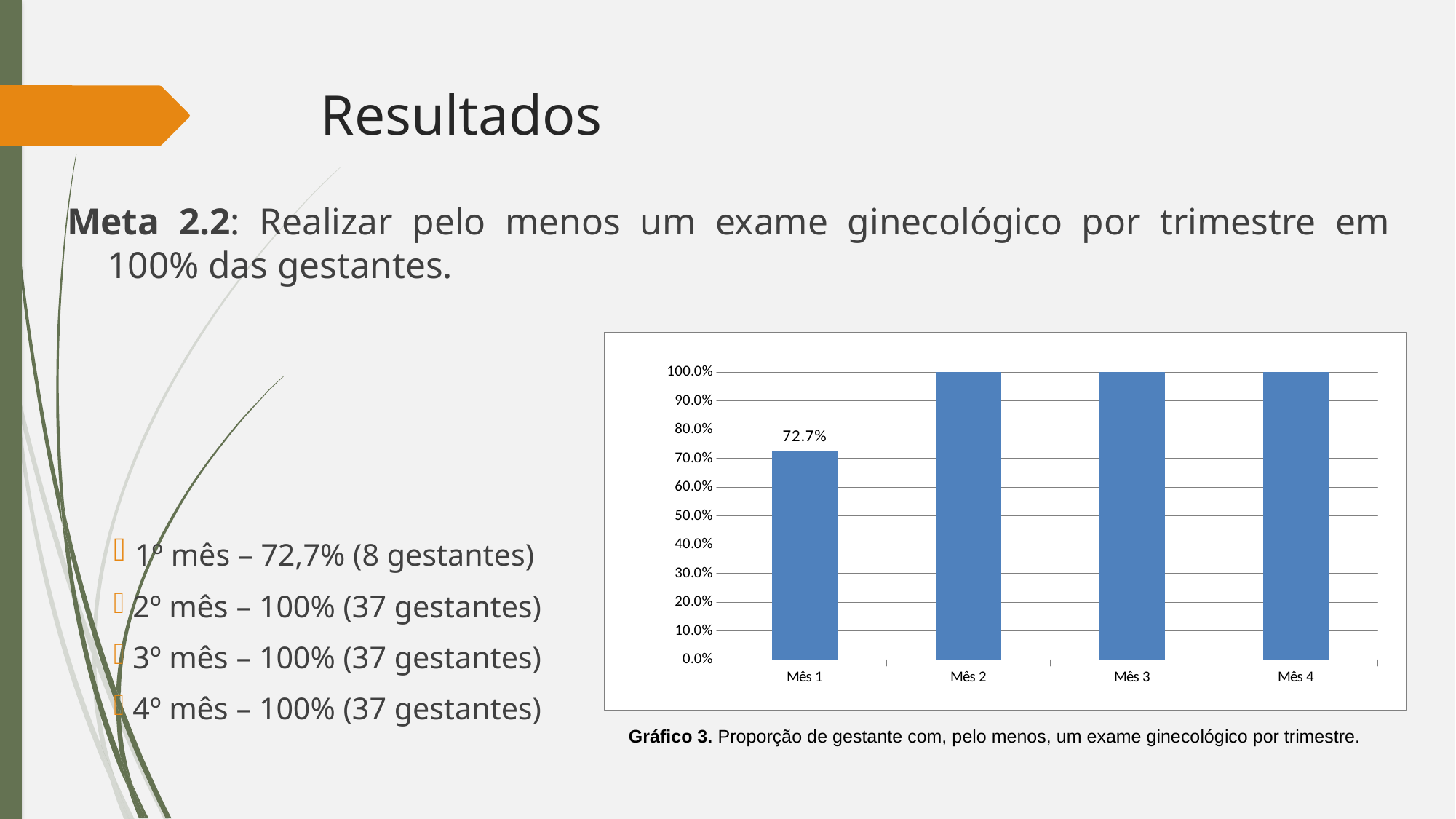
Do the values rise or fall from Mês 1 to Mês 2? rise Which is larger, the value for Mês 1 or the value for Mês 3? Mês 3 Which month has the lowest value? Mês 1 What kind of chart is shown? bar chart What is the value for Mês 2? 100.0% What is the highest value shown on the y axis? 100.0% What is the value for Mês 4? 100.0% Is the value for Mês 1 greater or less than 80.0%? less What is the value for Mês 1? 72.7% Is the value for Mês 3 greater or less than 90.0%? greater How many categories are shown on the x axis? 4 What is the difference between the value for Mês 2 and the value for Mês 1? 27.3%